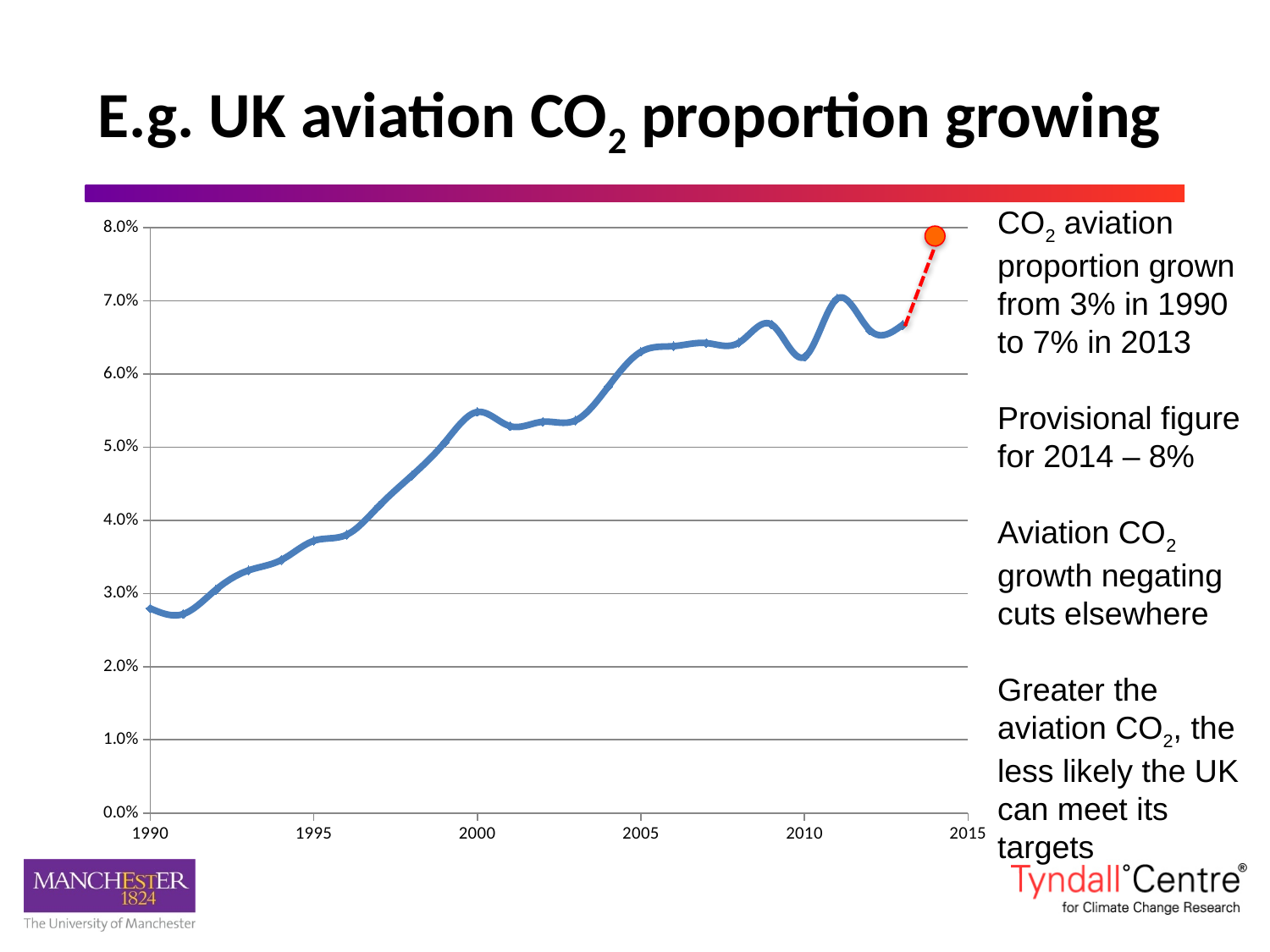
Is the value for 1991 greater or less than 3.0%? less What is the provisional figure for 2014 marked by the red point on the chart? 8% Do the values on the chart generally rise or fall from 1990 to 2013? rise Which is larger, the value for 2000 or the value for 1995? 2000 Is the value for 1995 greater or less than 4.0%? less Is the value for 2000 greater or less than 5.0%? greater What is the highest value shown on the vertical axis of the chart? 8.0% What years does the horizontal axis of the chart span? 1990 to 2015 What kind of chart is shown on the slide? line chart